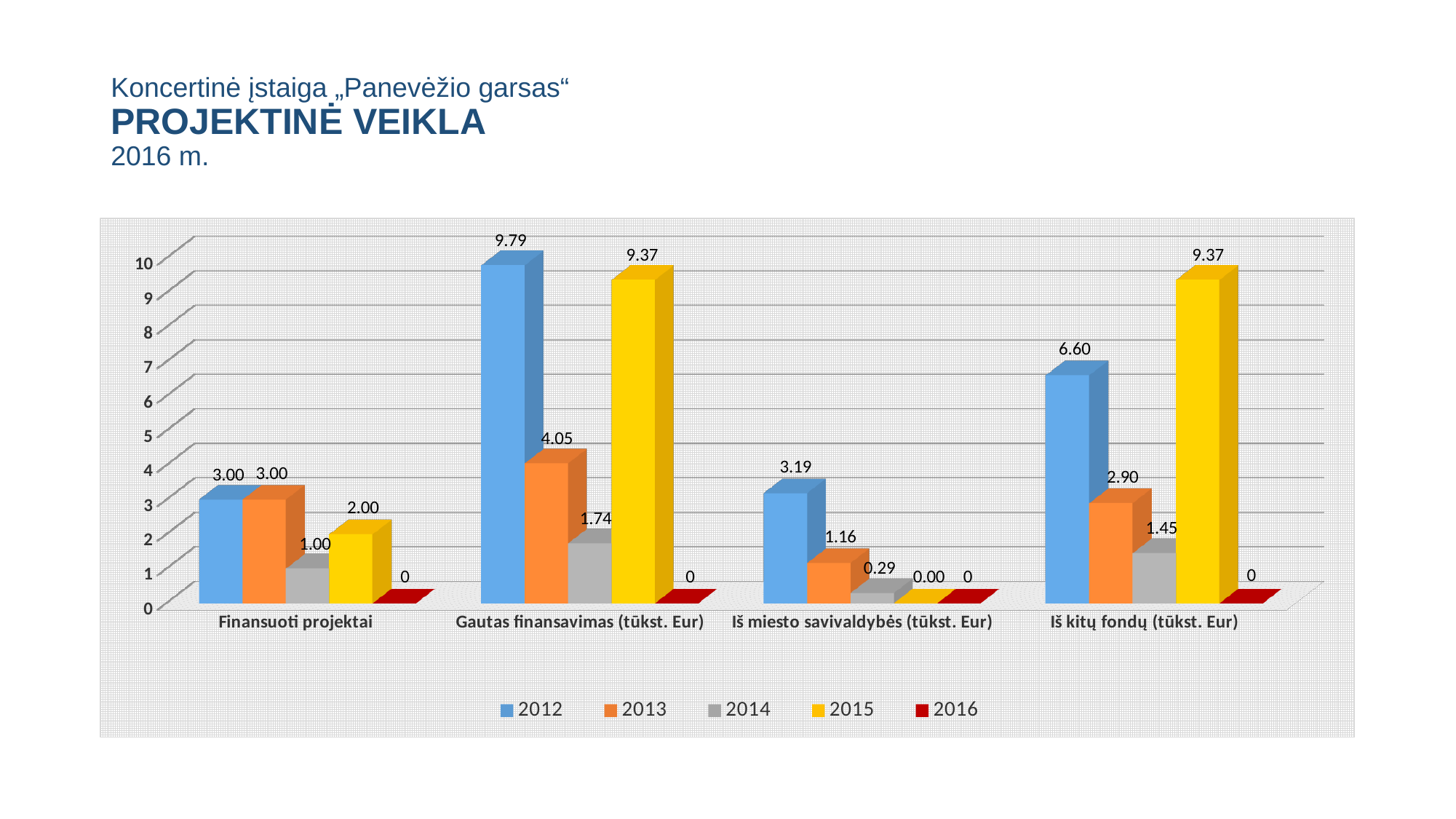
What kind of chart is shown on the slide? Bar chart What is the value for 2013 in the "Finansuoti projektai" category? 3.00 Which year has the lowest non-zero value in the "Gautas finansavimas (tūkst. Eur)" category? 2014 What is the value for 2012 in the "Gautas finansavimas (tūkst. Eur)" category? 9.79 Which is larger in the "Iš kitų fondų (tūkst. Eur)" category: the 2012 value or the 2013 value? 2012 Which year has the highest value in the "Iš kitų fondų (tūkst. Eur)" category? 2015 What is the difference between the 2012 and 2015 values in the "Gautas finansavimas (tūkst. Eur)" category? 0.42 Which colour represents the 2015 series in the legend? Yellow What is the value for 2015 in the "Iš kitų fondų (tūkst. Eur)" category? 9.37 How many categories are shown on the x axis? 4 How many series does the legend list? 5 What is the value for 2014 in the "Iš miesto savivaldybės (tūkst. Eur)" category? 0.29